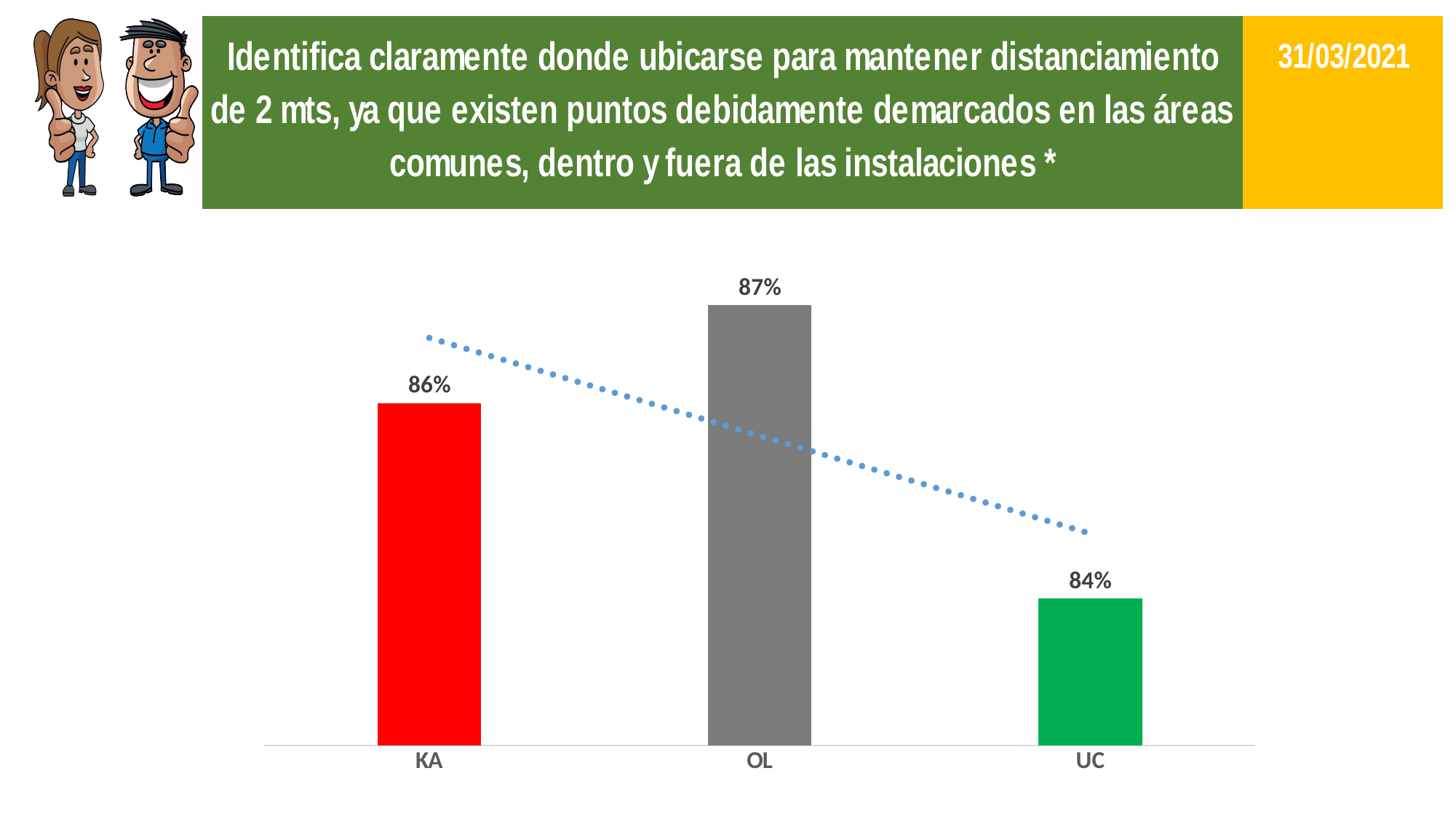
Which category has the highest value? OL What kind of chart is shown on the slide? bar chart What colour is the bar for UC? green Which is larger, the value for KA or the value for UC? KA What is the difference between the values for KA and UC? 2% What is the difference between the values for OL and UC? 3% What is the value for OL? 87% What is the value for UC? 84% What is the value for KA? 86% Which category has the lowest value? UC How many categories are shown on the x axis? 3